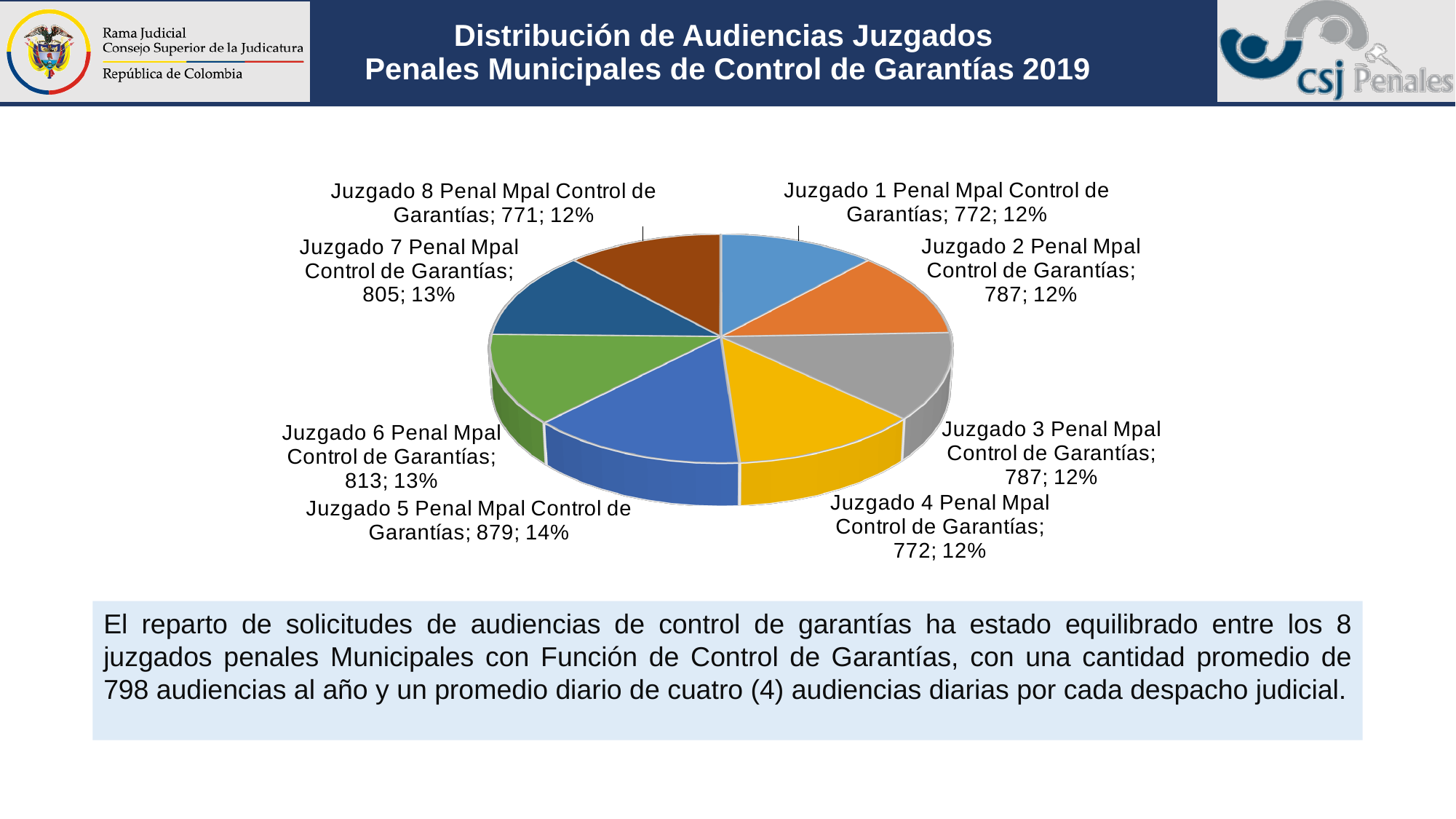
Which has more audiencias, Juzgado 6 or Juzgado 7 Penal Mpal Control de Garantías? Juzgado 6 Penal Mpal Control de Garantías How many slices does the pie chart have? 8 What is the difference between the values for Juzgado 5 and Juzgado 8 Penal Mpal Control de Garantías? 108 What is the title of the chart on the slide? Distribución de Audiencias Juzgados Penales Municipales de Control de Garantías 2019 What value is shown for Juzgado 7 Penal Mpal Control de Garantías? 805 What kind of chart is shown on the slide? Pie chart How many audiencias are shown for Juzgado 5 Penal Mpal Control de Garantías? 879 Which juzgado has the lowest number of audiencias? Juzgado 8 Penal Mpal Control de Garantías What value is shown for Juzgado 2 Penal Mpal Control de Garantías? 787 Which juzgado has the highest number of audiencias? Juzgado 5 Penal Mpal Control de Garantías What percentage share does Juzgado 6 Penal Mpal Control de Garantías have? 13% What percentage share does Juzgado 5 Penal Mpal Control de Garantías have? 14%